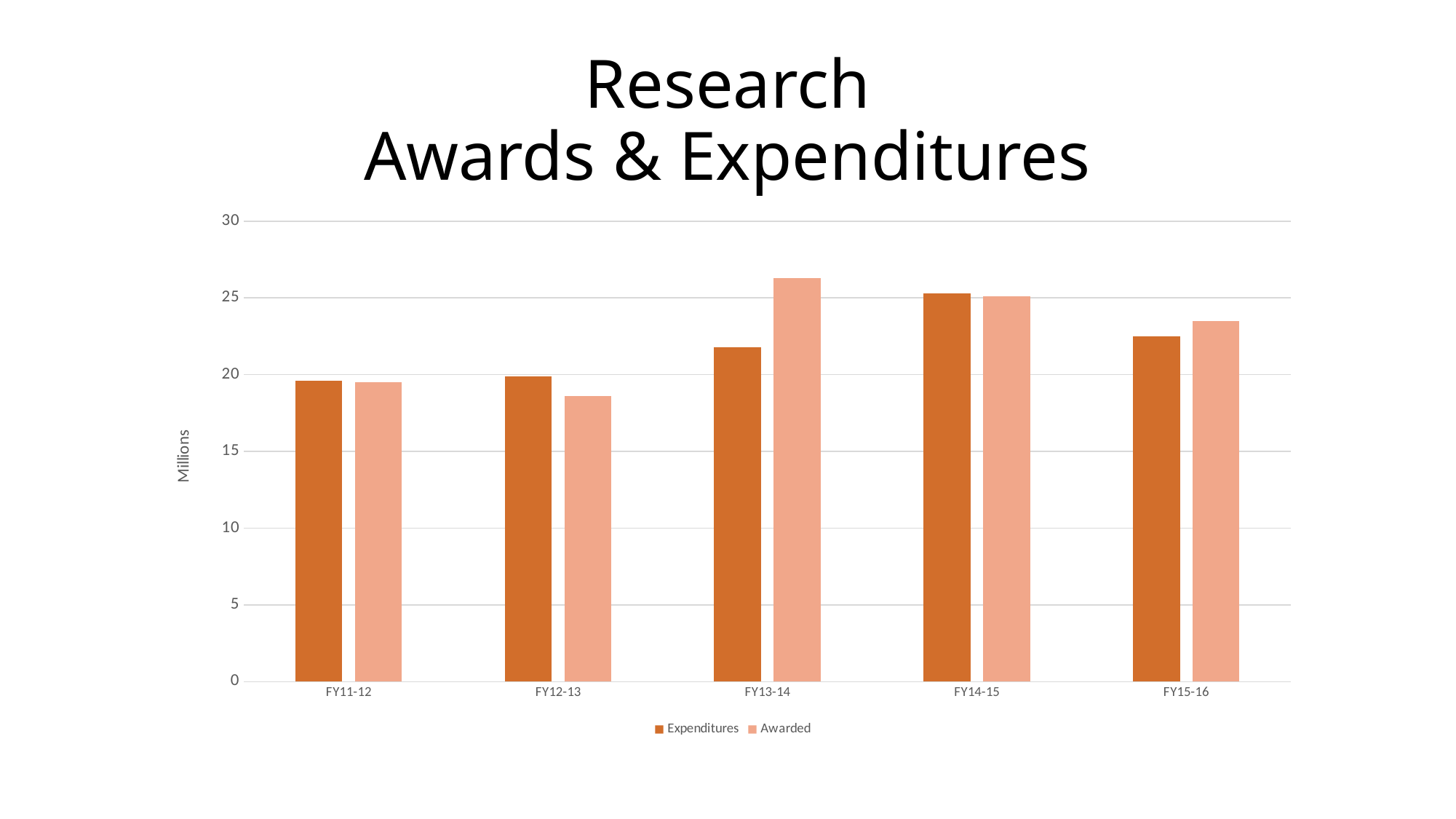
In which fiscal year is the Expenditures value highest? FY14-15 What kind of chart is shown on the slide? bar chart How many fiscal years are shown on the x axis? 5 Is the Awarded value for FY12-13 greater or less than 20? less In which fiscal year is the Awarded value highest? FY13-14 In which fiscal year is the Awarded value lowest? FY12-13 How many series does the legend list? 2 What unit is shown on the vertical axis label? Millions In FY12-13, which is larger, Expenditures or Awarded? Expenditures In FY13-14, which is larger, Expenditures or Awarded? Awarded Do the Expenditures values rise or fall from FY11-12 to FY14-15? rise Is the Awarded value for FY13-14 greater or less than 25? greater